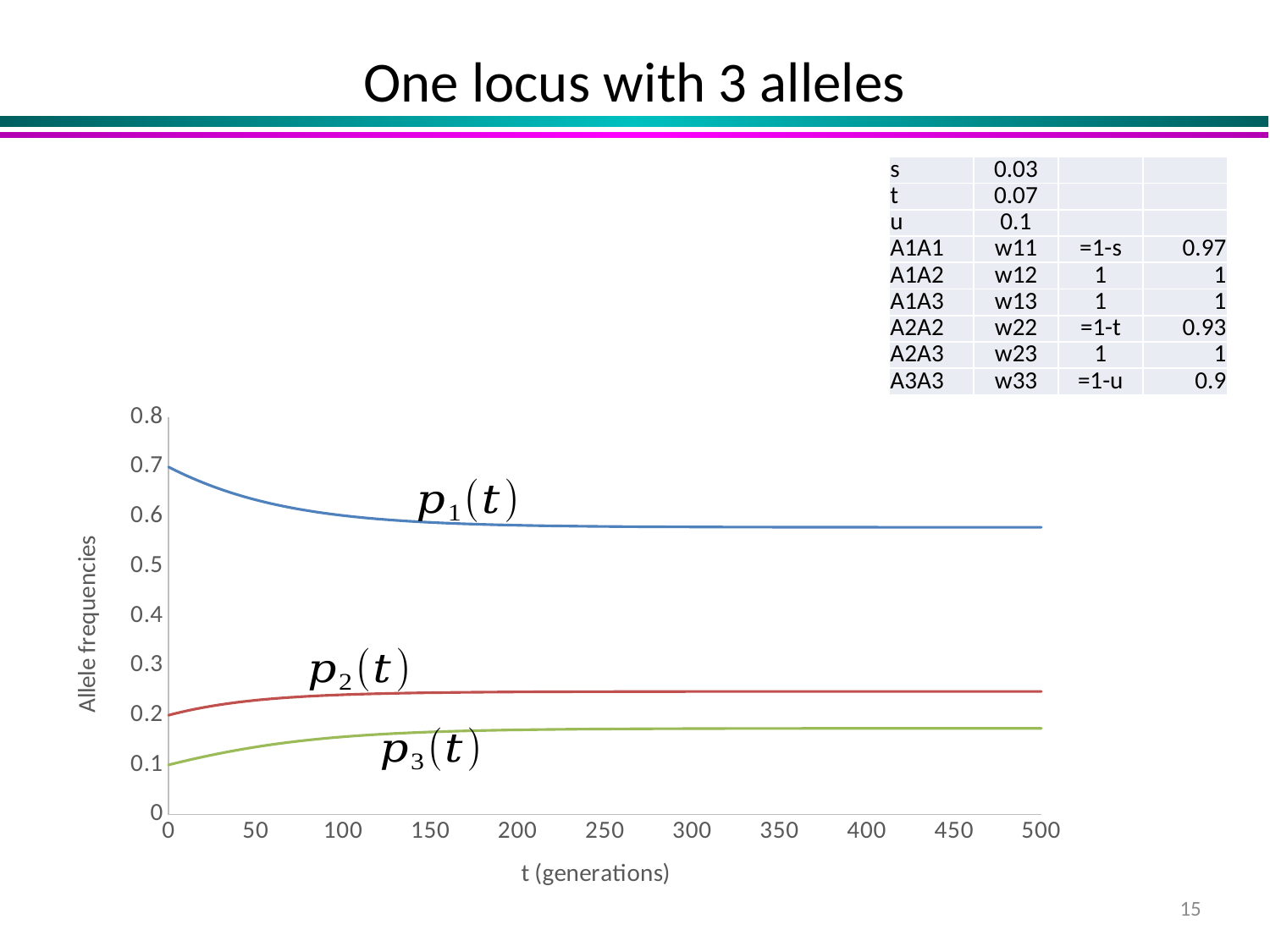
What is the label of the x axis of the chart? t (generations) Which series has the highest value at t = 500? p1(t) How many lines (series) are plotted on the chart? 3 Which series has the lowest value at t = 500? p3(t) Is the value of p3(t) at t = 500 greater or less than 0.2? less What is the value of p1(t) at t = 0? 0.7 Does p2(t) rise or fall as t increases from 0 to 500? rise What kind of chart is shown on the slide? line chart Is the value of p2(t) at t = 500 greater or less than 0.3? less Does p1(t) rise or fall as t increases from 0 to 500? fall Does p3(t) rise or fall as t increases from 0 to 500? rise Is the value of p1(t) at t = 500 greater or less than 0.5? greater